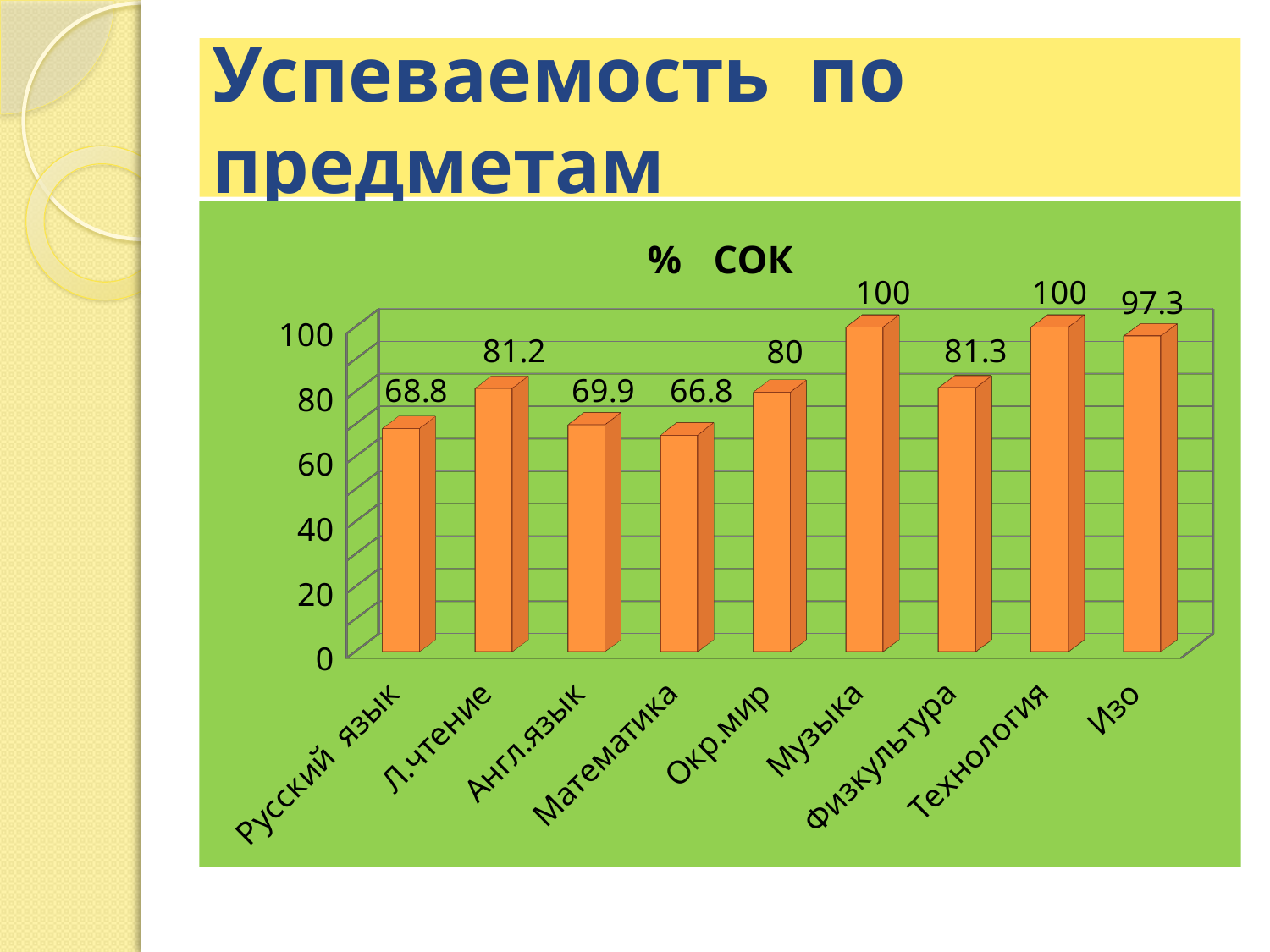
What is the value for Математика? 66.8 What is the value for Л.чтение? 81.2 What kind of chart is shown on the slide? bar chart Which categories share the highest value of 100? Музыка and Технология Which category has the lowest value? Математика How many categories are shown on the x axis? 9 What is the value for Изо? 97.3 What is the title of the chart? % СОК Is the value for Русский язык greater or less than 80? less What is the value for Окр.мир? 80 Which is larger, the value for Англ.язык or the value for Окр.мир? Окр.мир What is the difference between the values for Физкультура and Русский язык? 12.5